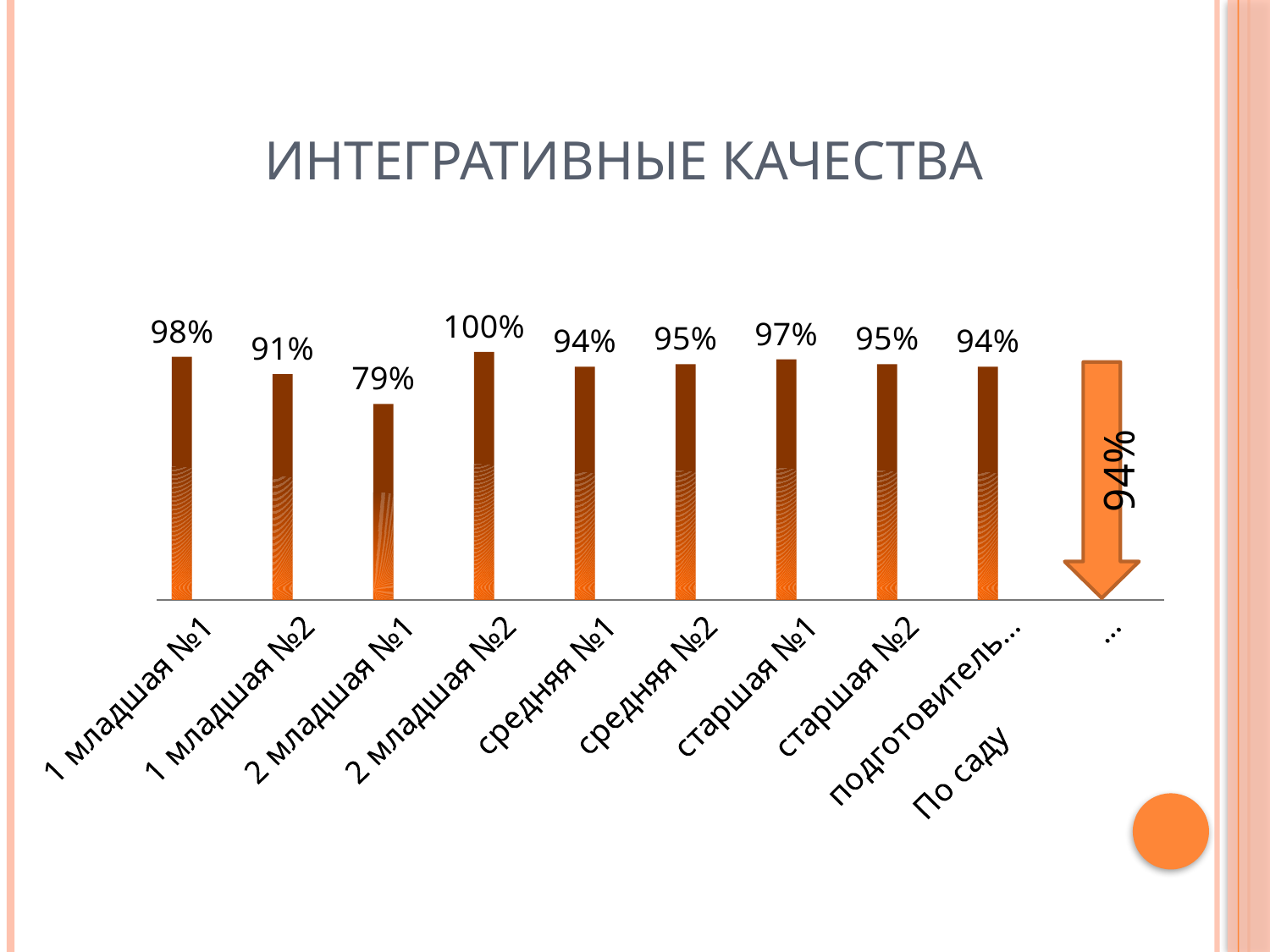
Which category has the lowest value? 2 младшая №1 What is the difference between the values for 2 младшая №2 and 2 младшая №1? 21 percentage points What is the value for 2 младшая №1? 79% What is the title of the slide? ИНТЕГРАТИВНЫЕ КАЧЕСТВА Which is larger, the value for 1 младшая №1 or 1 младшая №2? 1 младшая №1 What kind of chart is shown on the slide? Bar chart What is the value for средняя №2? 95% What is the value for 1 младшая №1? 98% Which category has the highest value? 2 младшая №2 What value is shown on the arrow for По саду? 94% What is the value for старшая №1? 97% How many bars are plotted in the chart? 9